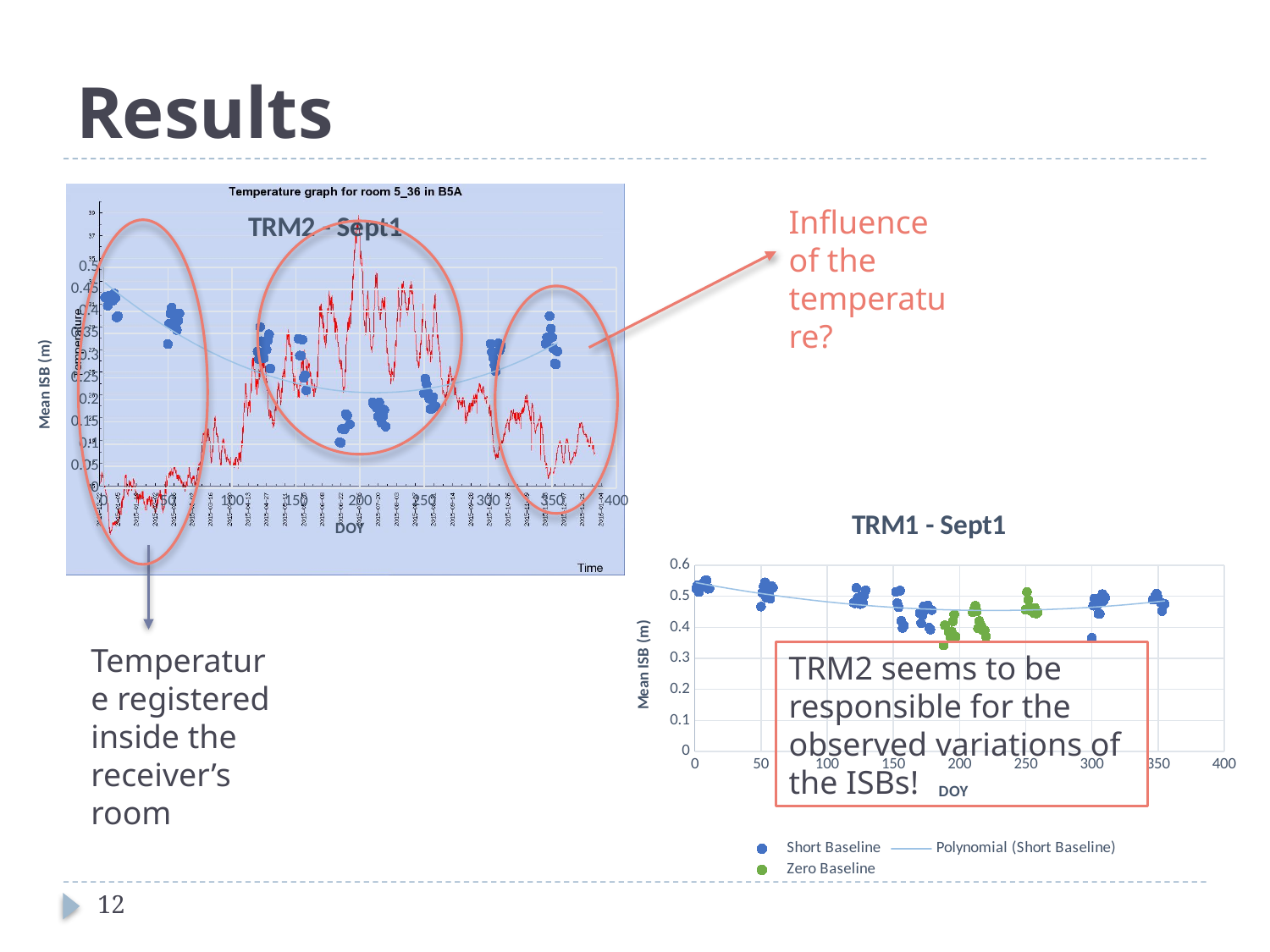
In the 'TRM1 - Sept1' chart, does the Polynomial (Short Baseline) trend line fall or rise between DOY 0 and DOY 200? fall What is the highest value shown on the y axis of the 'TRM2 - Sept1' chart? 0.5 In the 'TRM1 - Sept1' chart, what colour are the 'Zero Baseline' points? green In the 'TRM2 - Sept1' chart, are the values near DOY 200 greater or less than 0.25? less In the 'TRM1 - Sept1' chart, which is higher: the Short Baseline values near DOY 10 or the Zero Baseline values near DOY 200? Short Baseline values near DOY 10 In the 'TRM1 - Sept1' chart, are the Zero Baseline values near DOY 200 greater or less than 0.5? less What is the y-axis label of the 'TRM1 - Sept1' chart? Mean ISB (m) What kind of chart is the 'TRM1 - Sept1' chart on the right of the slide? scatter chart In the 'TRM1 - Sept1' chart, are the Short Baseline values near DOY 10 greater or less than 0.5? greater How many entries does the legend of the 'TRM1 - Sept1' chart list? 3 In the 'TRM2 - Sept1' chart, which is higher: the values near DOY 10 or the values near DOY 200? values near DOY 10